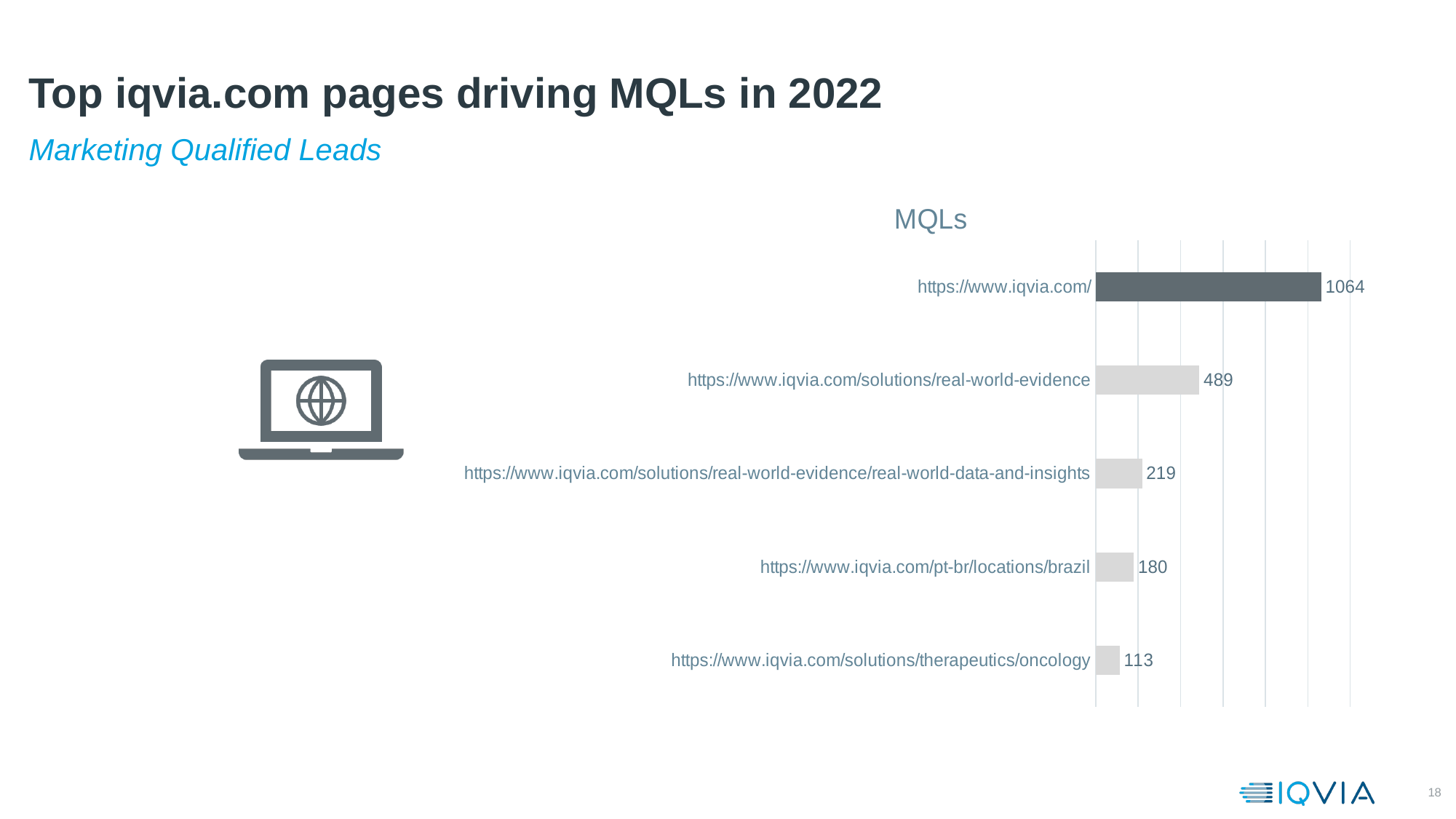
What type of chart is shown on the slide? Bar chart Which page has the lowest number of MQLs? https://www.iqvia.com/solutions/therapeutics/oncology What is the value for https://www.iqvia.com/solutions/therapeutics/oncology? 113 Which page has the highest number of MQLs? https://www.iqvia.com/ What is the title of the chart? MQLs Which has more MQLs: https://www.iqvia.com/pt-br/locations/brazil or https://www.iqvia.com/solutions/therapeutics/oncology? https://www.iqvia.com/pt-br/locations/brazil How many MQLs did https://www.iqvia.com/ drive according to the chart? 1064 What is the difference in MQLs between https://www.iqvia.com/ and https://www.iqvia.com/solutions/real-world-evidence? 575 How many MQLs are shown for https://www.iqvia.com/pt-br/locations/brazil? 180 What is the MQL value for https://www.iqvia.com/solutions/real-world-evidence? 489 What is the difference in MQLs between https://www.iqvia.com/solutions/real-world-evidence/real-world-data-and-insights and https://www.iqvia.com/pt-br/locations/brazil? 39 How many pages are shown in the chart? 5